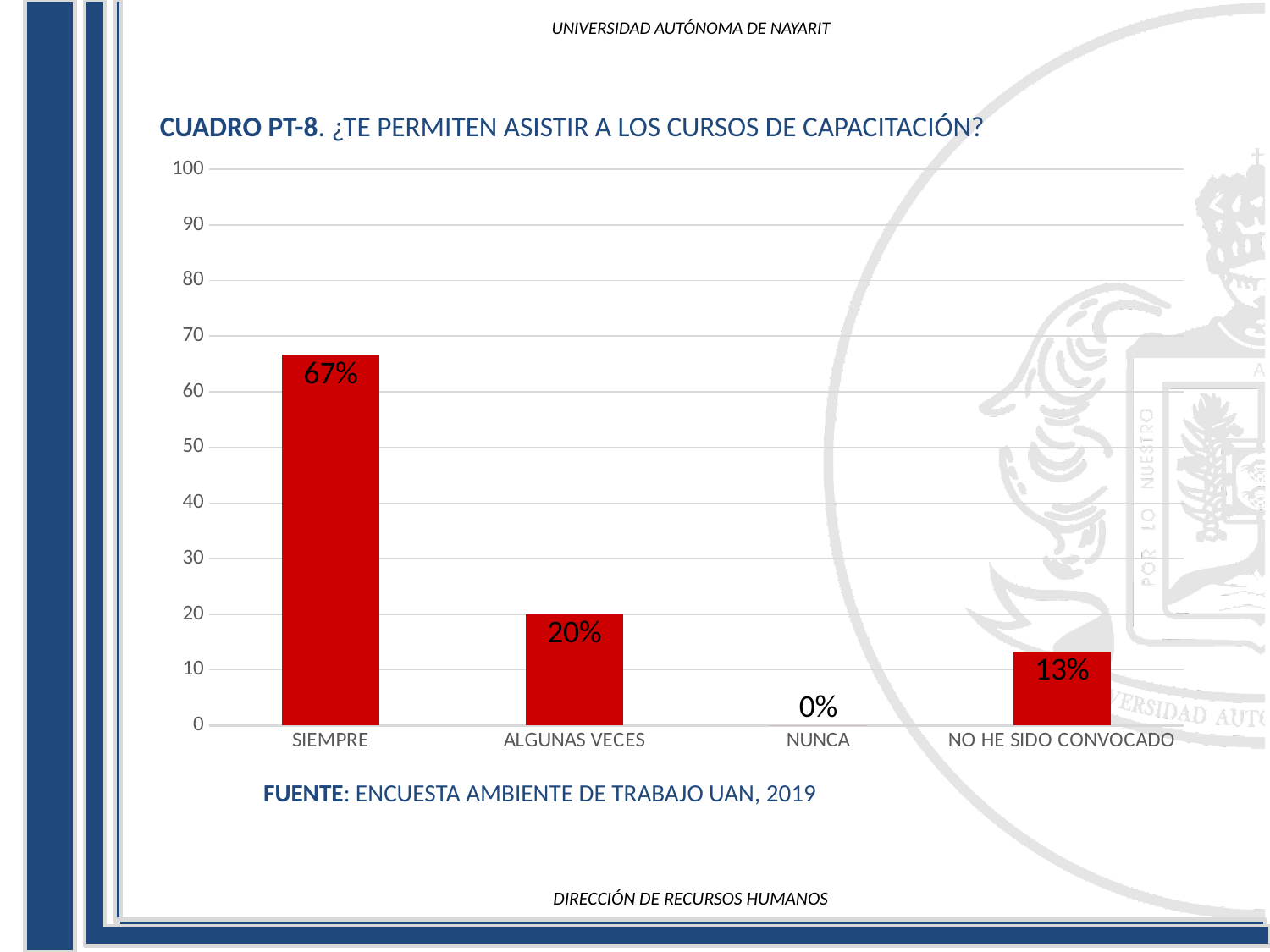
Which is larger, the value for ALGUNAS VECES or the value for NO HE SIDO CONVOCADO? ALGUNAS VECES What is the value for SIEMPRE? 67% What is the value for ALGUNAS VECES? 20% What is the source cited below the chart? ENCUESTA AMBIENTE DE TRABAJO UAN, 2019 How many categories are shown on the x axis? 4 Which category has the lowest value? NUNCA What kind of chart is shown on the slide? bar chart What is the value for NUNCA? 0% Which category has the highest value? SIEMPRE What is the difference between the values for SIEMPRE and ALGUNAS VECES? 47% Is the value for SIEMPRE greater or less than 50? greater What is the value for NO HE SIDO CONVOCADO? 13%